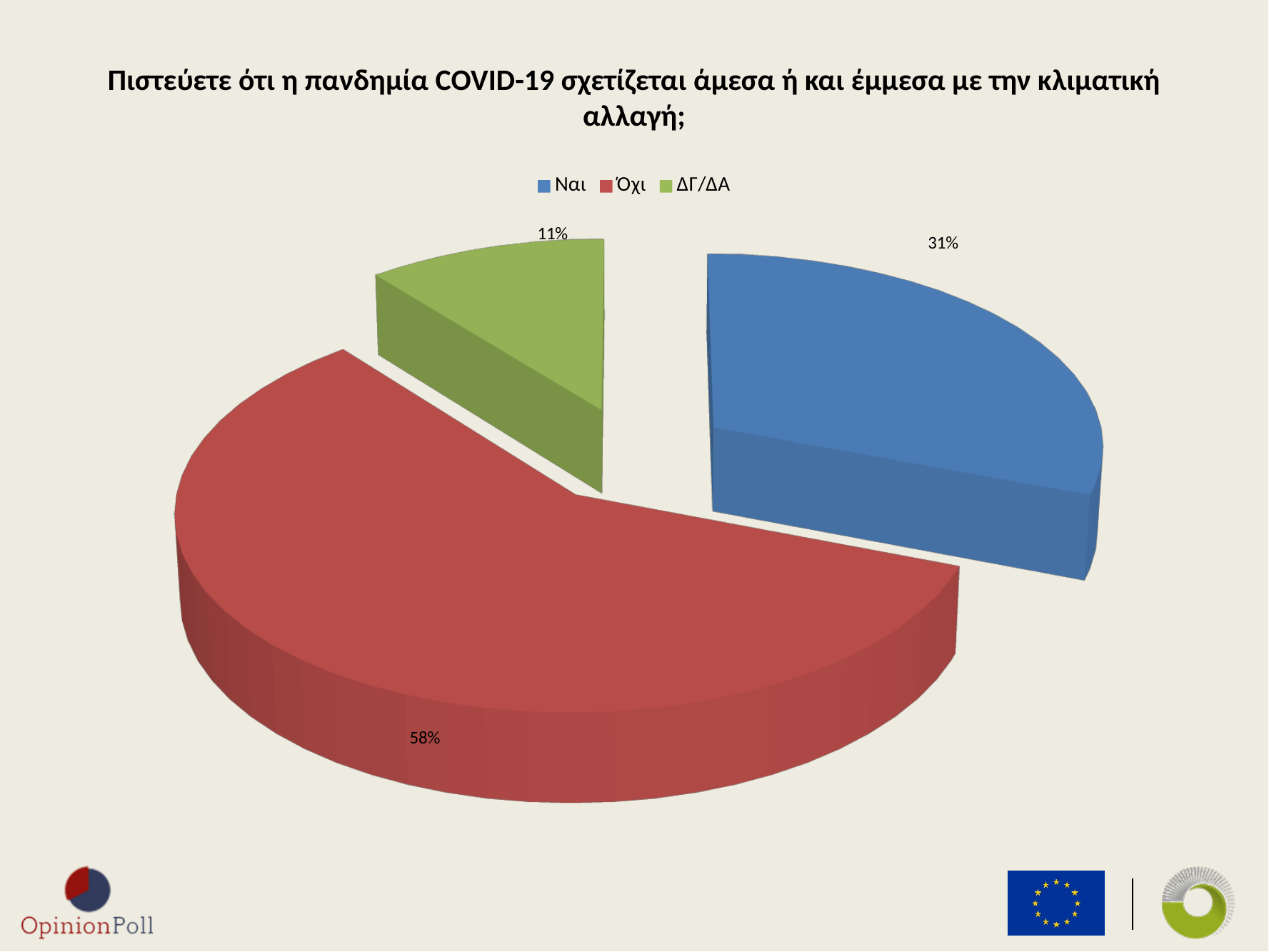
Which is larger, the share for Ναι or the share for ΔΓ/ΔΑ? Ναι How many entries does the legend list? 3 Which response has the smallest share of the pie? ΔΓ/ΔΑ What percentage of respondents answered Ναι? 31% What colour is the slice for Όχι? Red What percentage of respondents answered Όχι? 58% What is the difference in percentage points between Ναι and ΔΓ/ΔΑ? 20 What percentage of respondents answered ΔΓ/ΔΑ? 11% Which response has the largest share of the pie? Όχι What is the difference in percentage points between Όχι and Ναι? 27 What kind of chart is shown on the slide? Pie chart How many slices does the pie chart have? 3